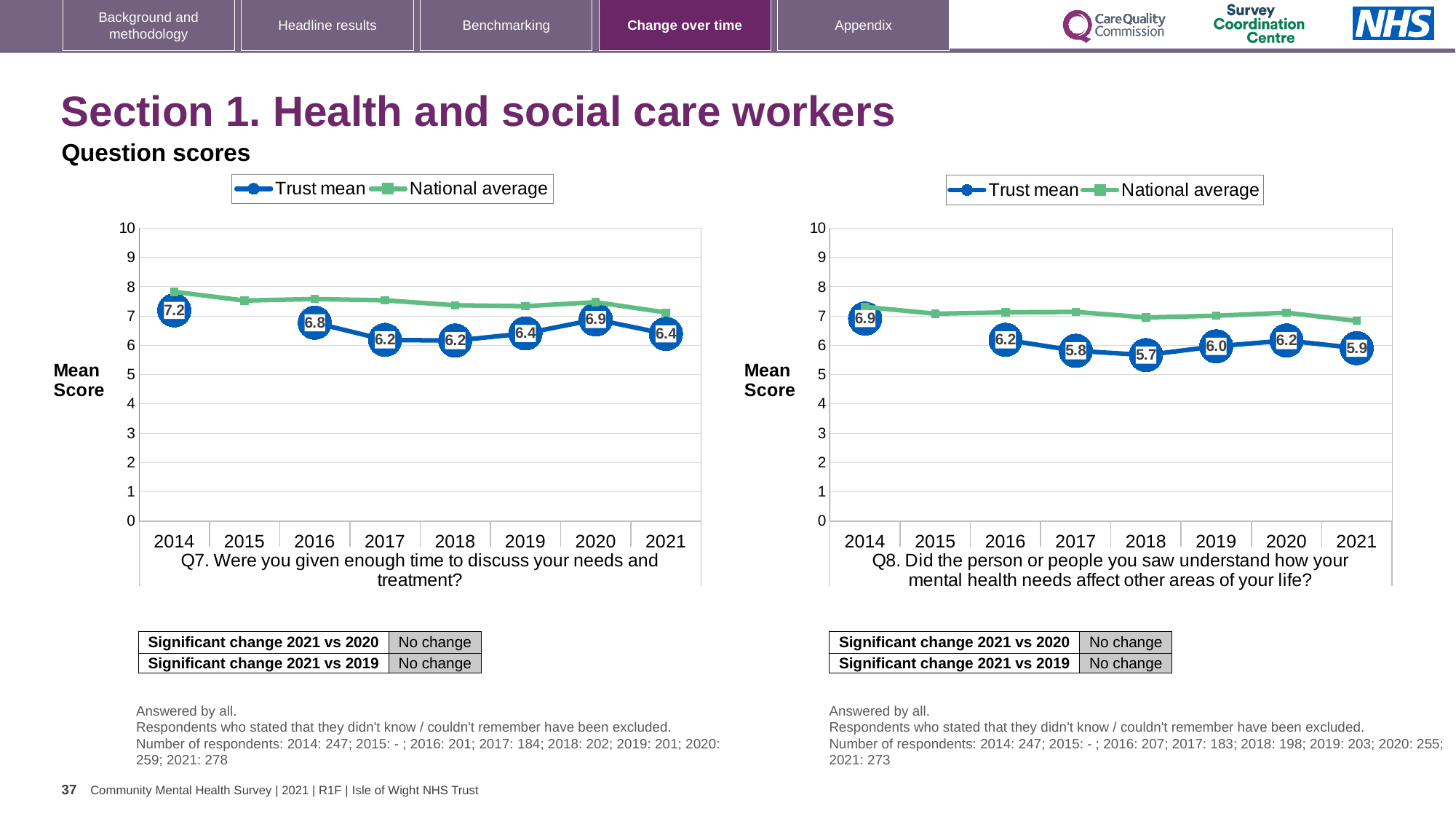
In the Q7 chart on the left, what is the Trust mean for 2020? 6.9 How many years are shown on the x axis of the Q8 chart on the right? 8 In the Q8 chart on the right, is the Trust mean higher in 2016 or in 2017? 2016 In the Q8 chart on the right, what is the Trust mean for 2018? 5.7 How many series does the legend of the Q7 chart on the left list? 2 In the Q8 chart on the right, which year has the lowest Trust mean? 2018 In the Q8 chart on the right, what is the Trust mean for 2021? 5.9 In the Q7 chart on the left, what is the Trust mean for 2014? 7.2 In the Q7 chart on the left, is the National average for 2014 greater or less than 7? greater In the Q7 chart on the left, what is the difference between the Trust mean in 2014 and in 2021? 0.8 What type of chart is the Q8 chart on the right? Line chart In the Q7 chart on the left, which year has the highest Trust mean? 2014